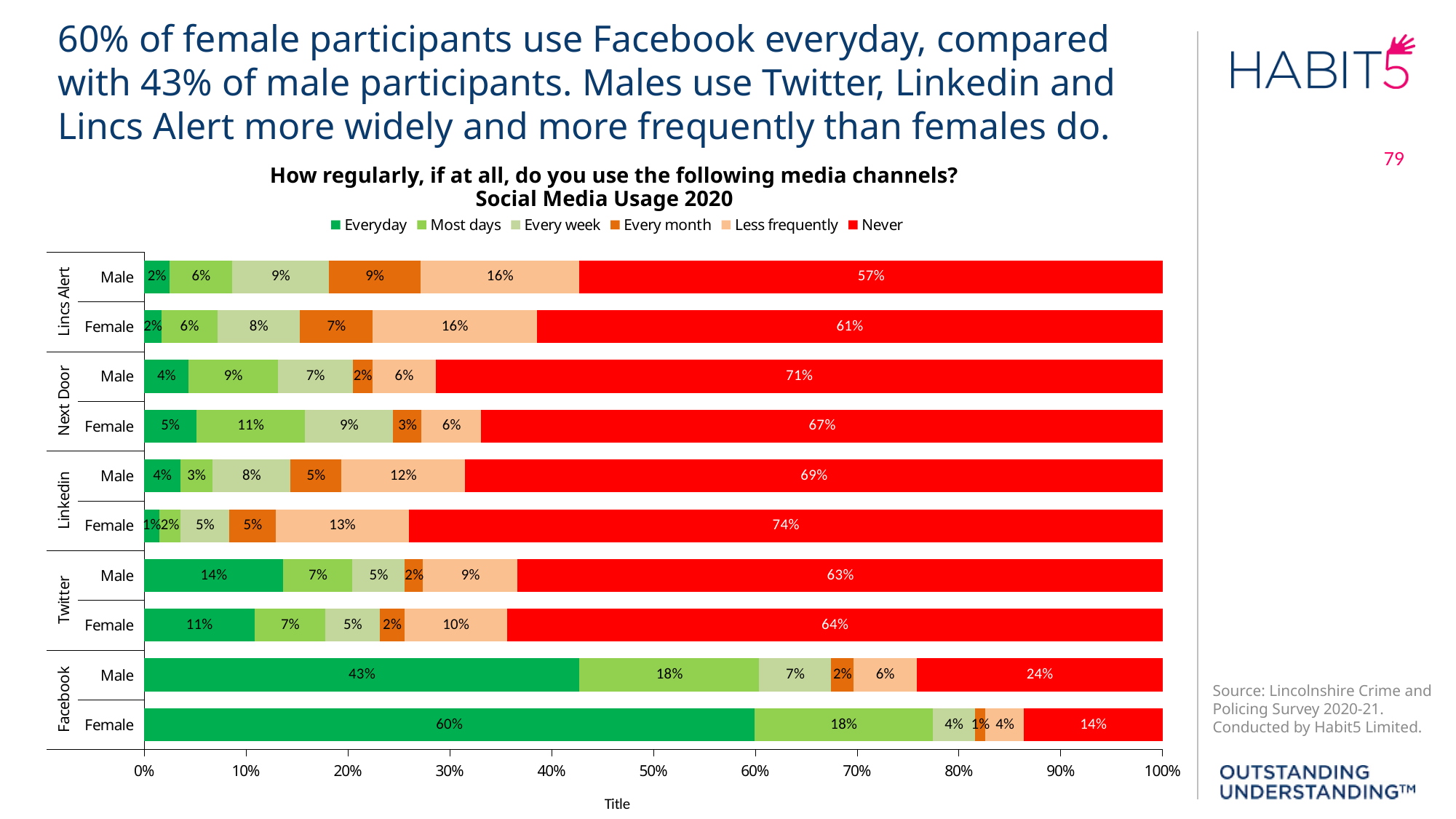
Which group has the highest 'Never' percentage? Linkedin Female (74%) What is the difference in percentage points between female and male participants who use Facebook everyday? 17 percentage points What percentage of female participants use Facebook everyday? 60% How many bars are shown in the chart? 10 What is the subtitle of the chart below the survey question? Social Media Usage 2020 What type of chart is shown on the slide? Stacked bar chart What percentage of male participants use Twitter everyday? 14% How many series does the legend list? 6 What percentage of female participants use Next Door most days? 11% Who has a higher 'Never' percentage for Next Door, males or females? Male Which group has the lowest 'Never' percentage? Facebook Female (14%) What percentage of male participants never use Lincs Alert? 57%